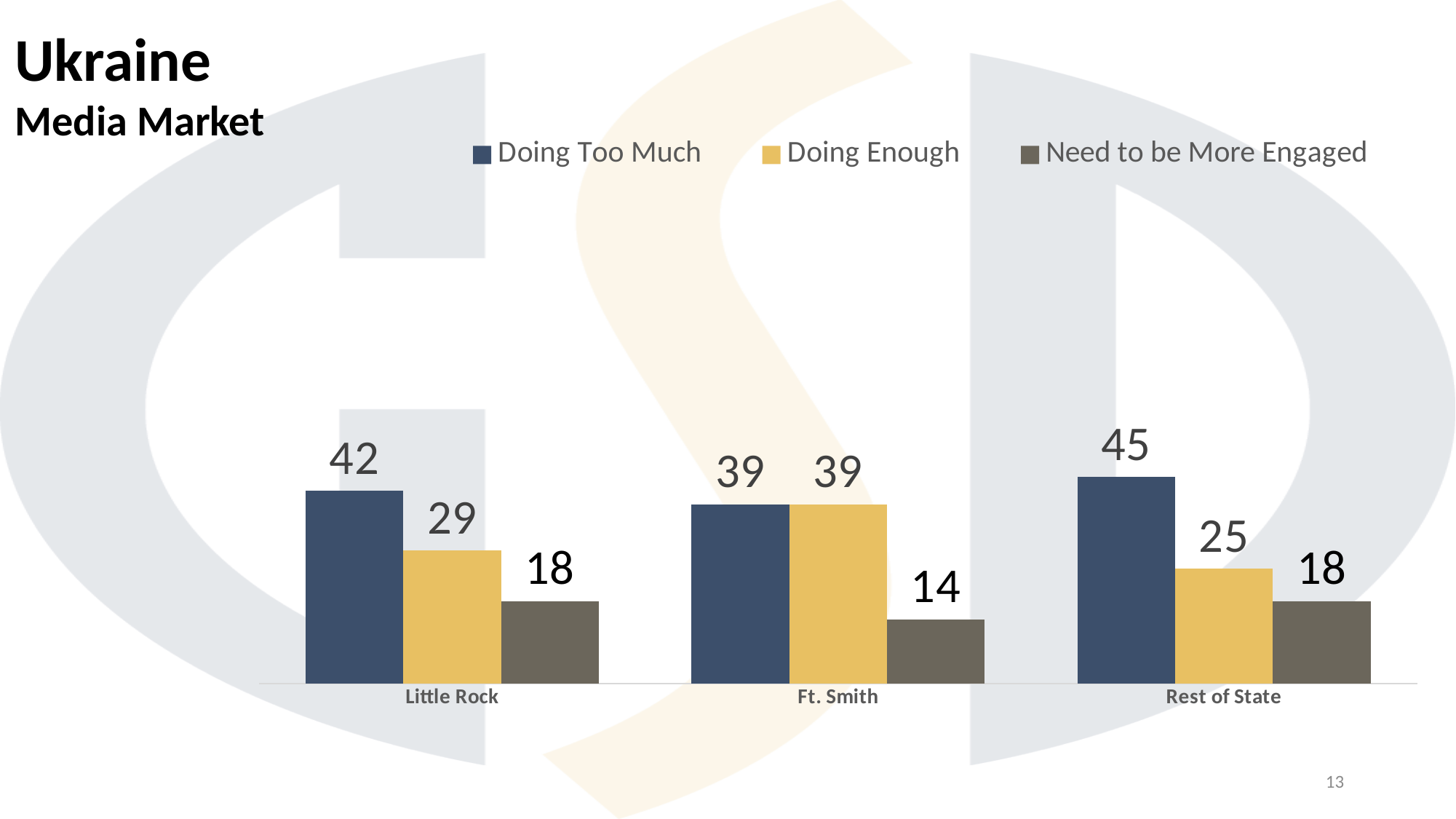
How many media markets are shown on the x axis? 3 What is the value for "Need to be More Engaged" in Rest of State? 18 Which media market has the lowest value for "Need to be More Engaged"? Ft. Smith What is the difference between "Doing Enough" in Ft. Smith and "Doing Enough" in Rest of State? 14 Which colour represents "Doing Enough" in the legend? Yellow What kind of chart is shown on the slide? Bar chart What is the difference between "Doing Too Much" and "Doing Enough" in Little Rock? 13 What is the value for "Doing Enough" in Ft. Smith? 39 What is the value for "Doing Too Much" in Little Rock? 42 How many series does the legend list? 3 Which media market has the highest value for "Doing Too Much"? Rest of State Which is larger in Rest of State: "Doing Too Much" or "Doing Enough"? Doing Too Much